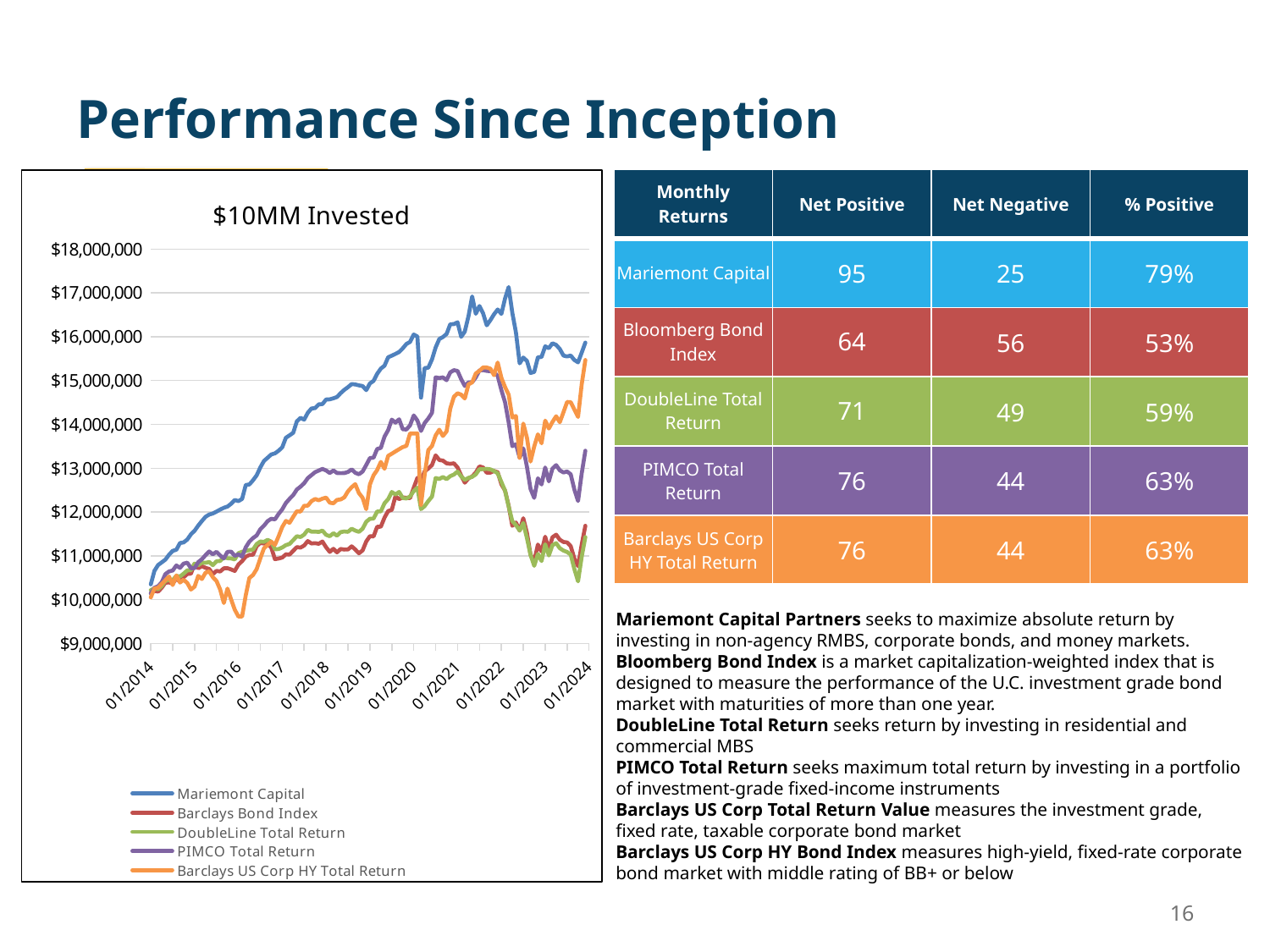
Which series has the highest value at 01/2024 on the chart? Mariemont Capital Is the value for PIMCO Total Return at 01/2024 greater or less than $12,000,000? greater Is the value for DoubleLine Total Return at 01/2024 greater or less than $12,000,000? less How many series does the legend of the chart list? 5 What is the title of the chart? $10MM Invested Does the Mariemont Capital line generally rise or fall from 01/2014 to 01/2024? rise Is the value for Barclays US Corp HY Total Return at 01/2024 greater or less than $14,000,000? greater How many date labels are shown on the x axis of the chart? 11 What kind of chart is shown on the slide? line chart Which series is plotted in blue on the chart? Mariemont Capital